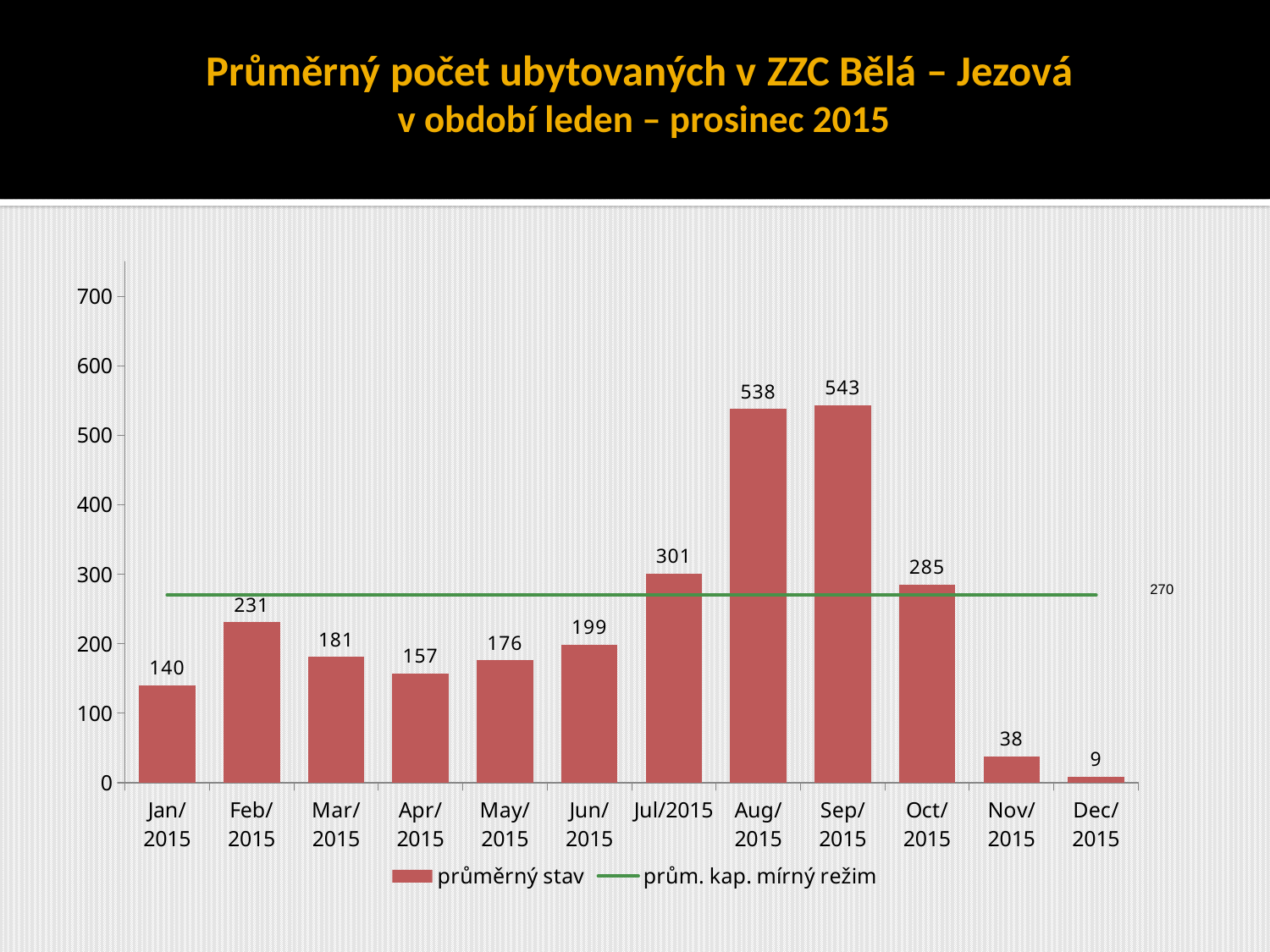
Is the value for Oct/2015 greater or less than 200? greater What is the difference between the values for Sep/2015 and Aug/2015? 5 How many months are shown on the x axis? 12 Which is larger, the value for Feb/2015 or the value for Mar/2015? Feb/2015 How many series does the legend list? 2 Which month has the lowest value? Dec/2015 What is the value for Aug/2015? 538 What is the value of the 'prům. kap. mírný režim' line? 270 Which month has the highest value? Sep/2015 What is the difference between the values for Jul/2015 and Jun/2015? 102 What is the value for Jan/2015? 140 What kind of chart is this? combination bar and line chart